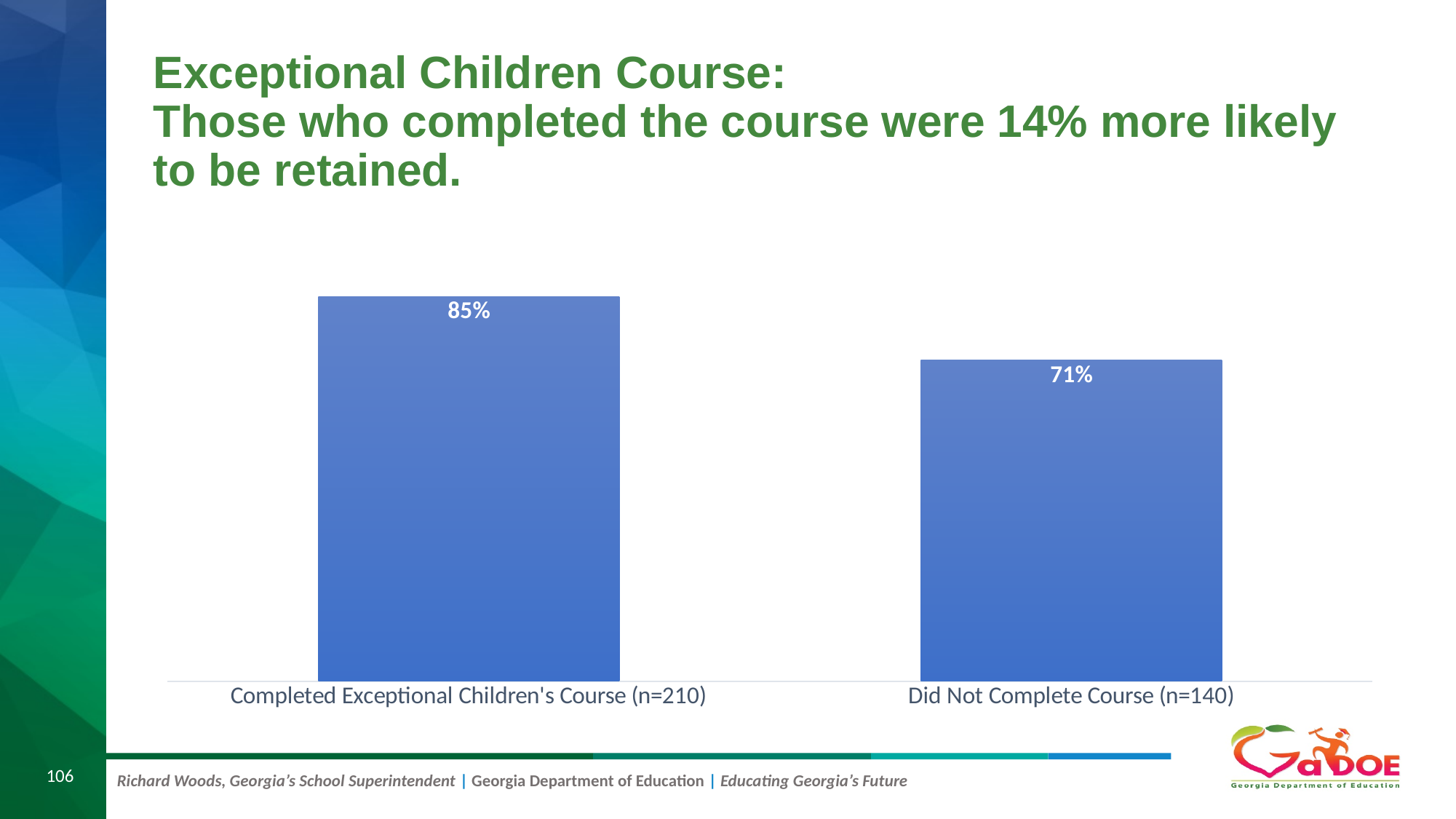
How many categories are shown in the chart? 2 What is the value for Completed Exceptional Children's Course (n=210)? 85% Which category has the highest value? Completed Exceptional Children's Course (n=210) What is the value for Did Not Complete Course (n=140)? 71% Do the values rise or fall from left to right across the categories? Fall What kind of chart is shown on the slide? Bar chart What is the sample size (n) shown for the Did Not Complete Course category? 140 What colour are the bars in the chart? Blue Which is larger: the value for Completed Exceptional Children's Course (n=210) or the value for Did Not Complete Course (n=140)? Completed Exceptional Children's Course (n=210) Which category has the lowest value? Did Not Complete Course (n=140) What is the difference between the value for Completed Exceptional Children's Course (n=210) and the value for Did Not Complete Course (n=140)? 14%